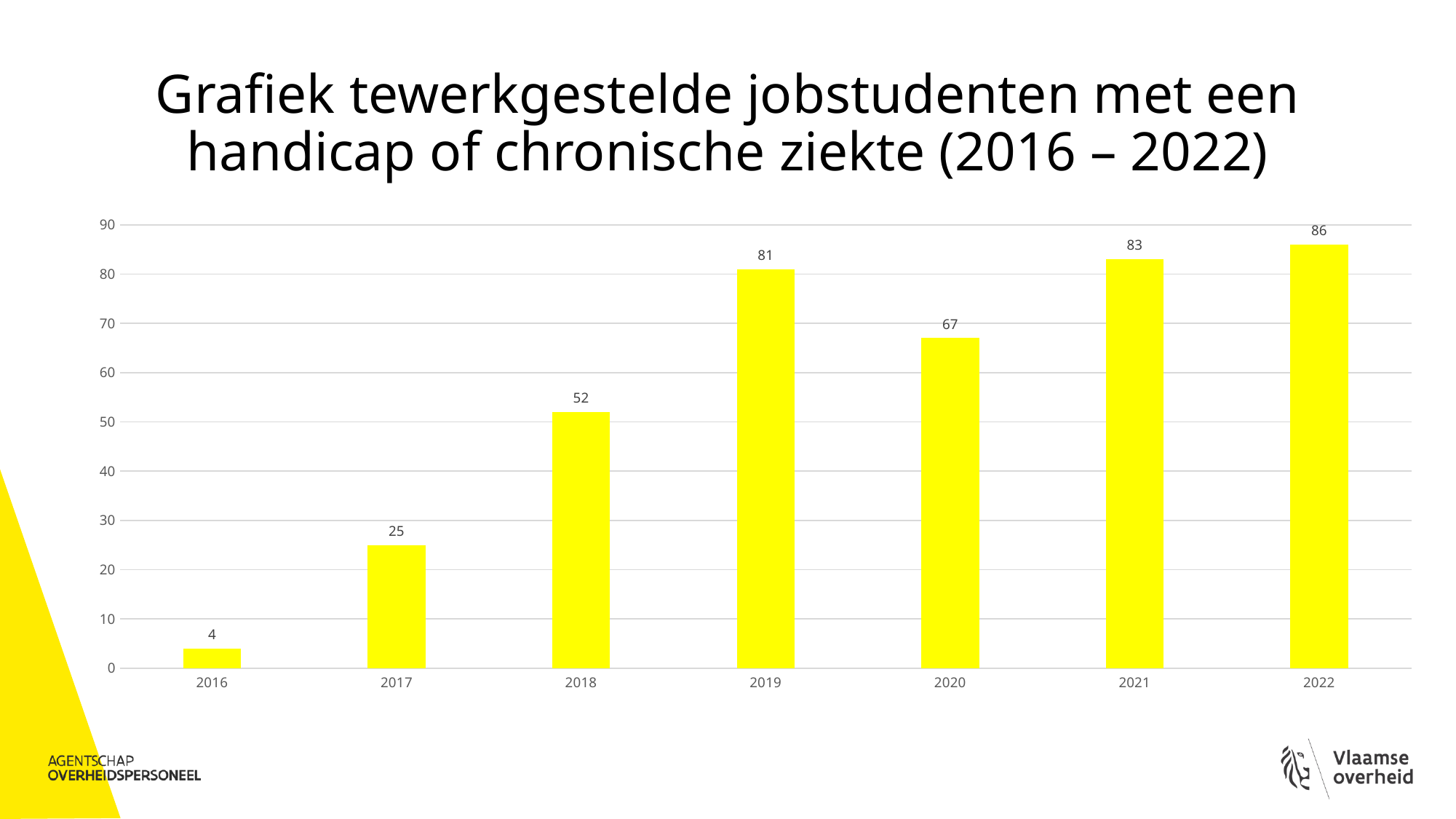
What is the value for 2016? 4 What colour are the bars in the chart? yellow What is the difference between the values for 2019 and 2020? 14 Is the value for 2017 greater or less than 30? less Which is larger, the value for 2018 or the value for 2020? 2020 What is the difference between the values for 2022 and 2021? 3 How many years are shown on the x axis? 7 Which year has the lowest value? 2016 Which year has the highest value? 2022 What kind of chart is shown on the slide? bar chart What is the value for 2020? 67 What is the value for 2019? 81